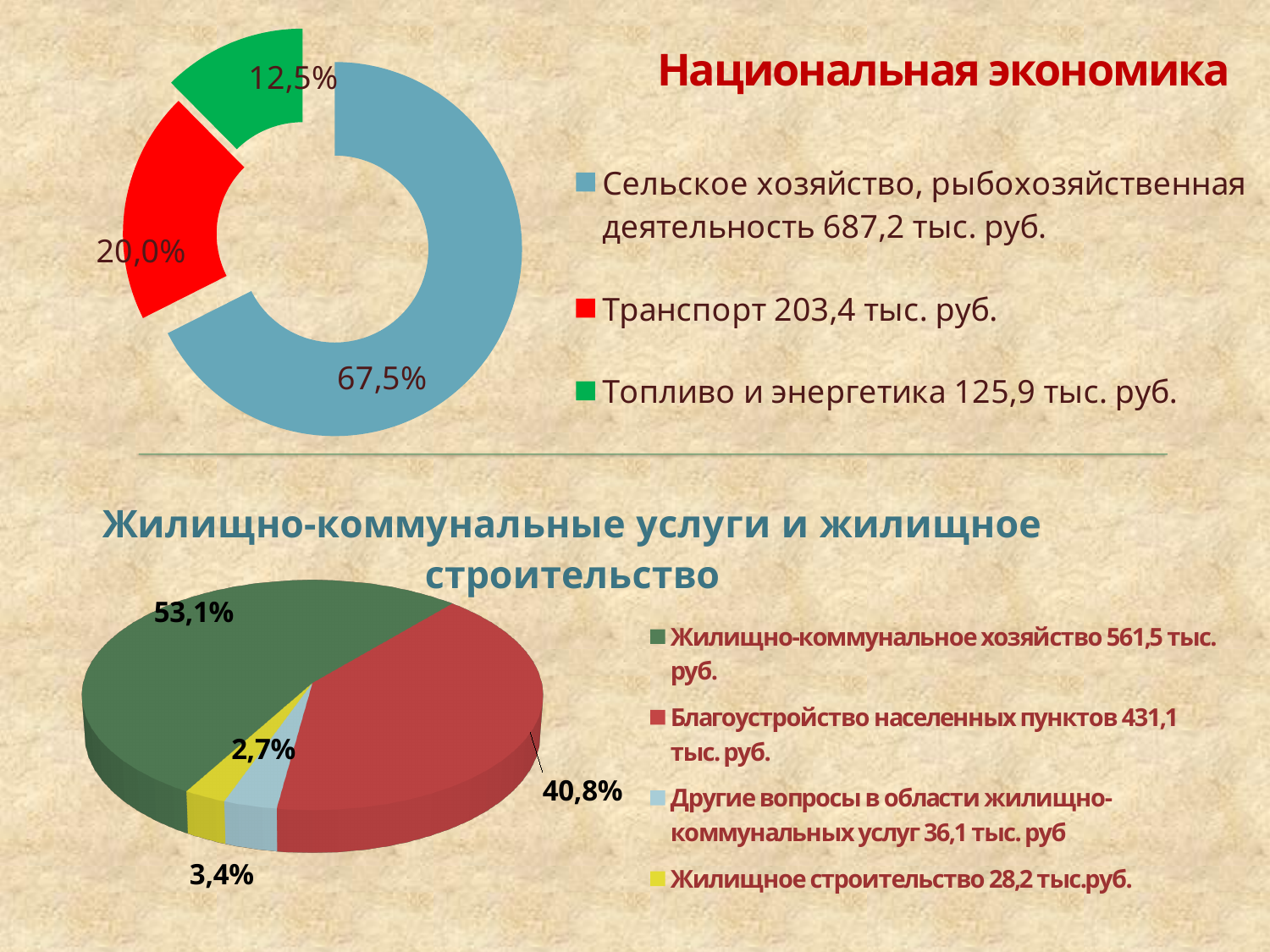
How many categories does the legend of the top chart 'Национальная экономика' list? 3 In the top chart 'Национальная экономика', what amount is listed in the legend for Транспорт? 203,4 тыс. руб. In the top chart 'Национальная экономика', what share does the red slice (Транспорт) have? 20,0% In the bottom chart 'Жилищно-коммунальные услуги и жилищное строительство', what is the difference in percentage points between the 53,1% slice and the 40,8% slice? 12,3 In the bottom chart 'Жилищно-коммунальные услуги и жилищное строительство', what amount is listed in the legend for Благоустройство населенных пунктов? 431,1 тыс. руб. What type of chart is the top chart titled 'Национальная экономика'? doughnut chart How many categories does the legend of the bottom chart 'Жилищно-коммунальные услуги и жилищное строительство' list? 4 In the top chart 'Национальная экономика', what share does the green slice (Топливо и энергетика) have? 12,5% In the top chart 'Национальная экономика', what percentage share is shown for the largest slice? 67,5% What type of chart is the bottom chart titled 'Жилищно-коммунальные услуги и жилищное строительство'? pie chart In the top chart 'Национальная экономика', which category has the smallest share? Топливо и энергетика